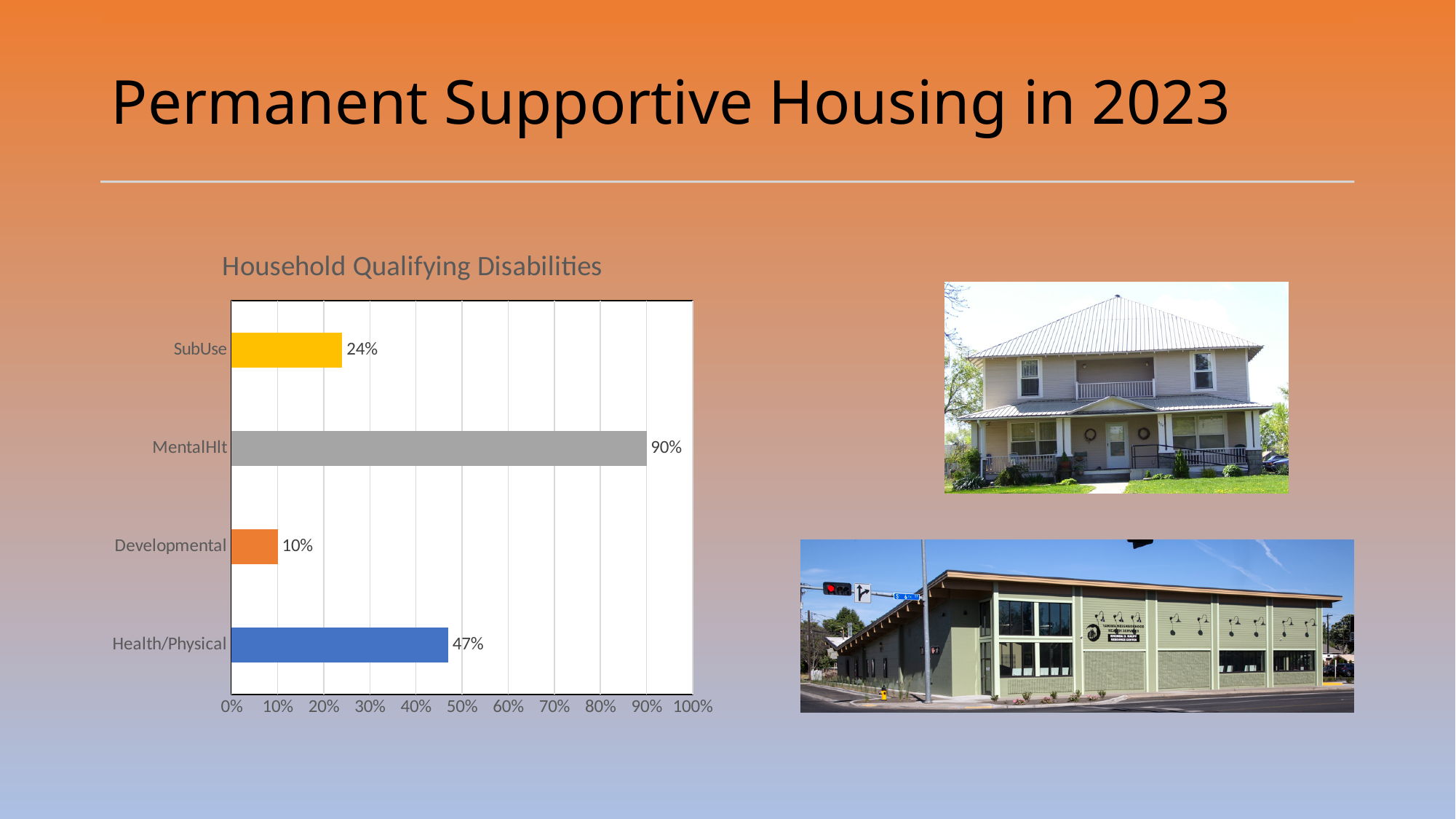
What is the difference between the values for MentalHlt and Health/Physical? 43% What kind of chart is shown on the slide? bar chart What is the value for SubUse? 24% What is the value for Health/Physical? 47% Which is larger, the value for SubUse or the value for Health/Physical? Health/Physical Which category has the lowest value? Developmental What is the title of the chart? Household Qualifying Disabilities Is the value for Health/Physical greater or less than 50%? less Which category has the highest value? MentalHlt What is the value for Developmental? 10% What is the value for MentalHlt? 90% How many categories are shown in the chart? 4